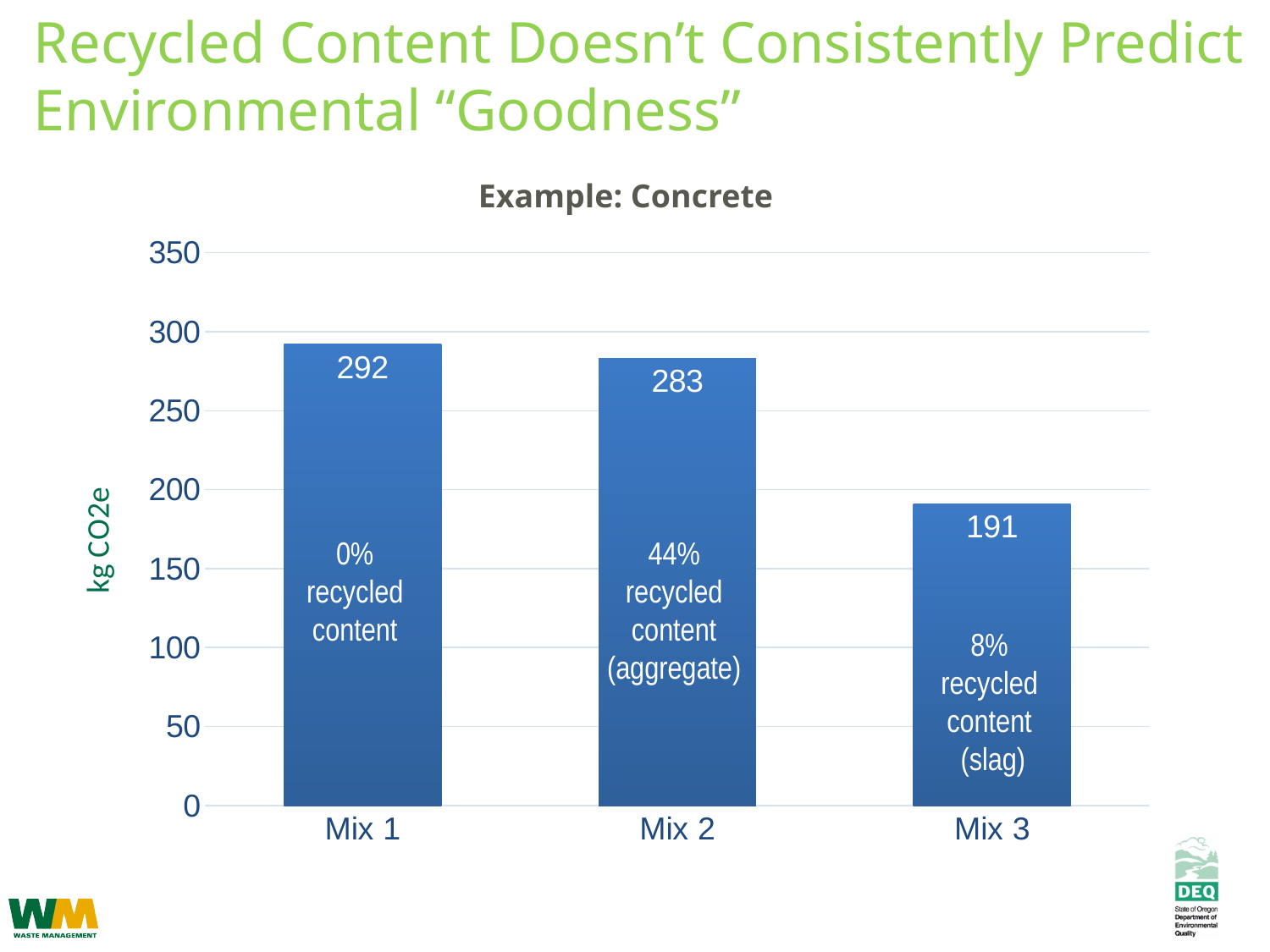
Is the value for Mix 3 greater or less than 200? less Which mix has the highest kg CO2e value? Mix 1 What is the difference between the values for Mix 1 and Mix 3? 101 What kind of chart is shown on the slide? bar chart Which mix has the lowest kg CO2e value? Mix 3 What is the value for Mix 3? 191 What is the label on the vertical axis of the chart? kg CO2e What is the value for Mix 2? 283 How many mixes are shown on the chart? 3 Which is larger, the value for Mix 2 or the value for Mix 3? Mix 2 What is the difference between the values for Mix 1 and Mix 2? 9 What is the value for Mix 1? 292